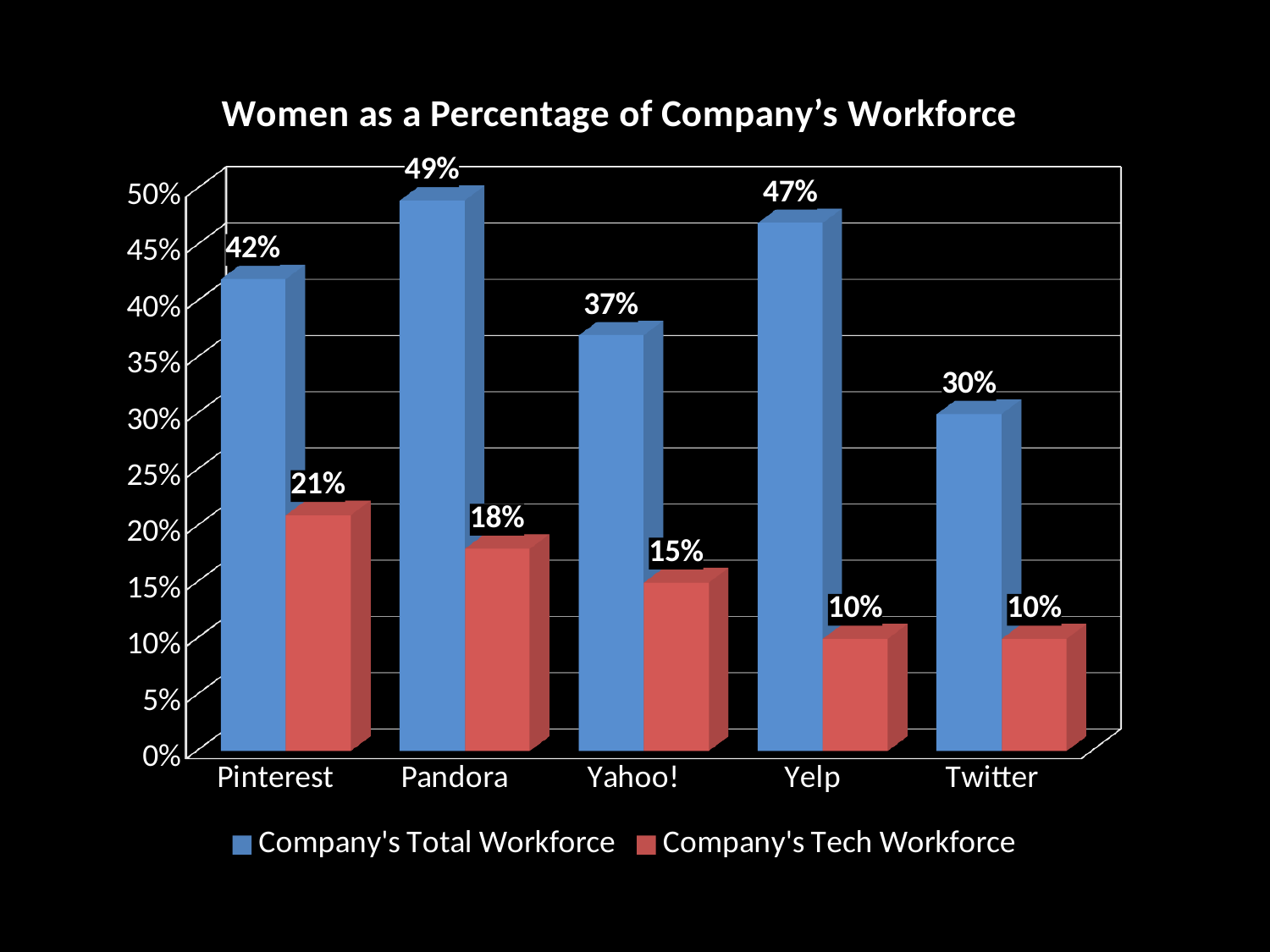
Which company has the highest value in the Company's Tech Workforce series? Pinterest What is the title of the chart? Women as a Percentage of Company's Workforce Which company has the lowest value in the Company's Total Workforce series? Twitter How many companies are shown on the x axis? 5 What is the value for Pandora in the Company's Total Workforce series? 49% Which is larger: Yelp's Company's Total Workforce value or Pinterest's Company's Total Workforce value? Yelp How many series does the legend list? 2 What is the difference between Pinterest's Company's Total Workforce value and its Company's Tech Workforce value? 21% What is the value for Twitter in the Company's Total Workforce series? 30% Which company has the highest value in the Company's Total Workforce series? Pandora What is the value for Yahoo! in the Company's Tech Workforce series? 15% What kind of chart is shown on the slide? Bar chart